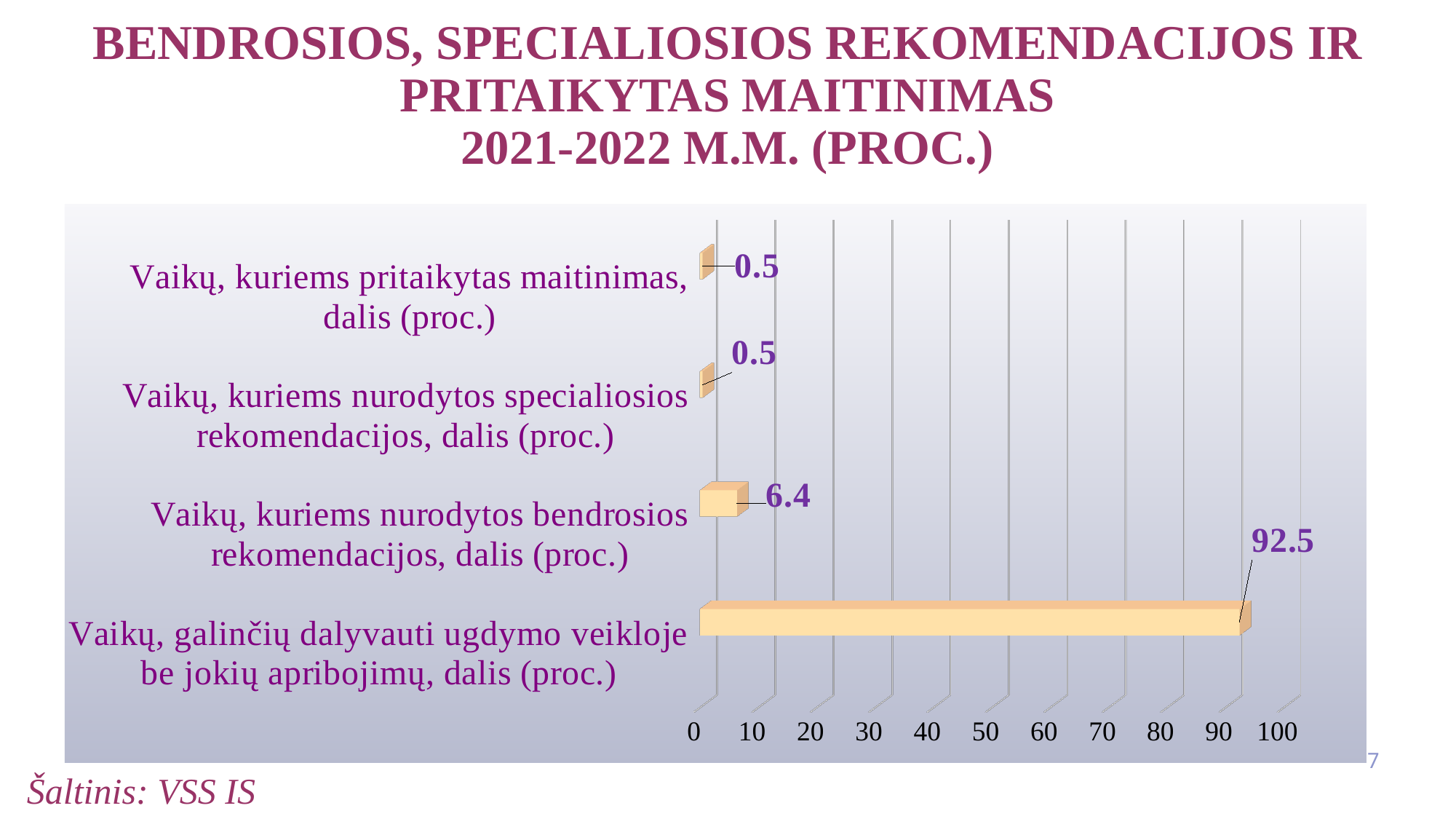
Is the value for "Vaikų, galinčių dalyvauti ugdymo veikloje be jokių apribojimų" greater or less than 90? greater What is the value for "Vaikų, kuriems nurodytos bendrosios rekomendacijos, dalis (proc.)"? 6.4 Which category has the highest value? Vaikų, galinčių dalyvauti ugdymo veikloje be jokių apribojimų, dalis (proc.) What is the value for "Vaikų, kuriems nurodytos specialiosios rekomendacijos, dalis (proc.)"? 0.5 Which is larger: the value for "Vaikų, kuriems nurodytos bendrosios rekomendacijos" or the value for "Vaikų, kuriems pritaikytas maitinimas"? Vaikų, kuriems nurodytos bendrosios rekomendacijos What is the difference between the value for "Vaikų, kuriems nurodytos bendrosios rekomendacijos" and the value for "Vaikų, kuriems nurodytos specialiosios rekomendacijos"? 5.9 What is the difference between the value for "Vaikų, galinčių dalyvauti ugdymo veikloje be jokių apribojimų" and the value for "Vaikų, kuriems nurodytos bendrosios rekomendacijos"? 86.1 What kind of chart is shown on the slide? bar chart What is the value for "Vaikų, kuriems pritaikytas maitinimas, dalis (proc.)"? 0.5 What is the highest tick value shown on the value axis? 100 What is the value for "Vaikų, galinčių dalyvauti ugdymo veikloje be jokių apribojimų, dalis (proc.)"? 92.5 How many categories are shown in the chart? 4